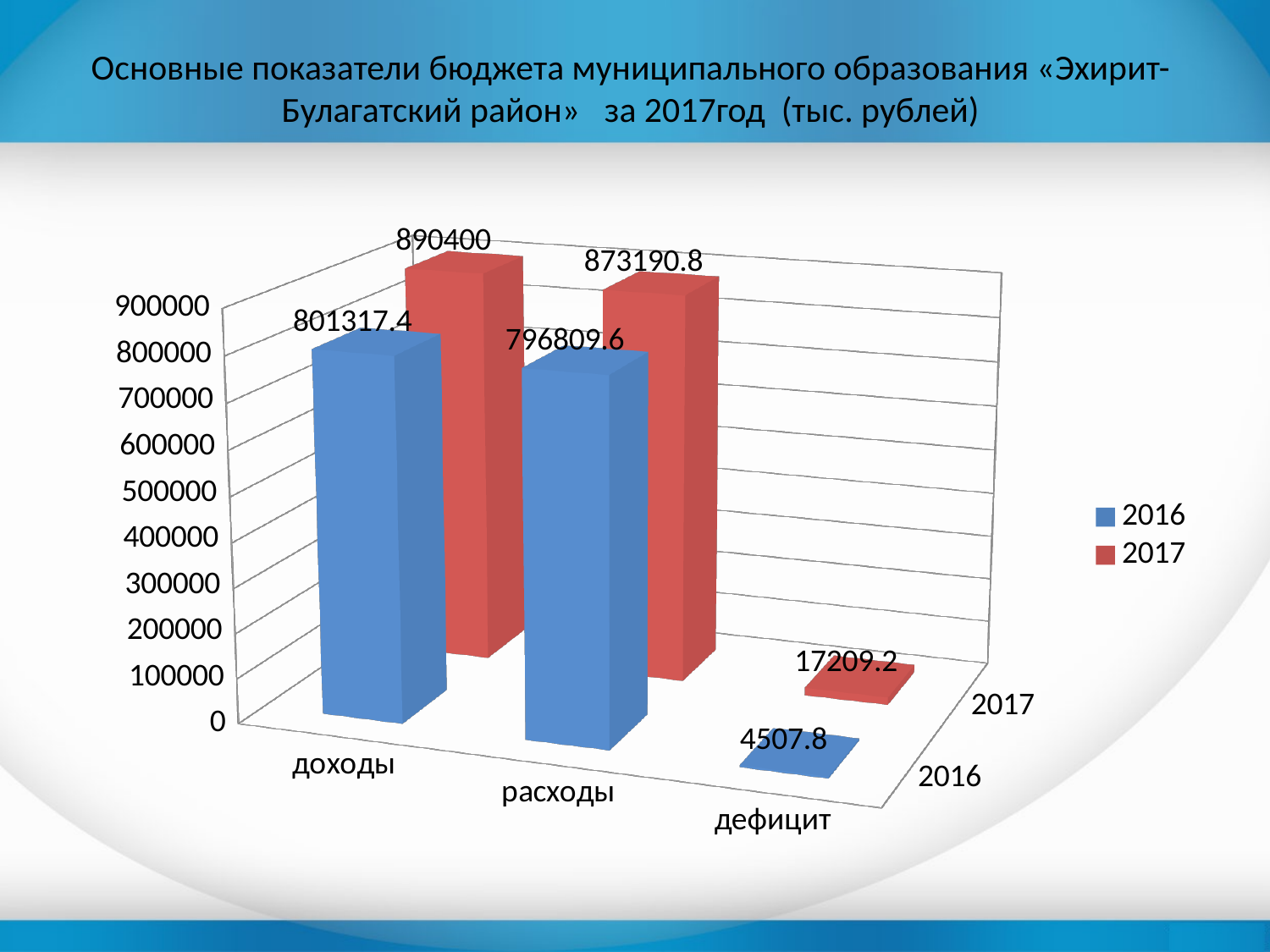
What kind of chart is shown on the slide? bar chart What is the value for доходы in 2016? 801317.4 How many categories are shown on the x axis? 3 Which category has the highest value in the 2017 series? доходы What is the value for дефицит in 2017? 17209.2 Which is larger: расходы in 2016 or расходы in 2017? расходы in 2017 What is the value for доходы in 2017? 890400 What is the value for расходы in 2016? 796809.6 What is the difference between the 2017 and 2016 values for доходы? 89082.6 Which category has the lowest value in the 2016 series? дефицит What is the difference between the 2017 and 2016 values for дефицит? 12701.4 How many series does the legend list? 2